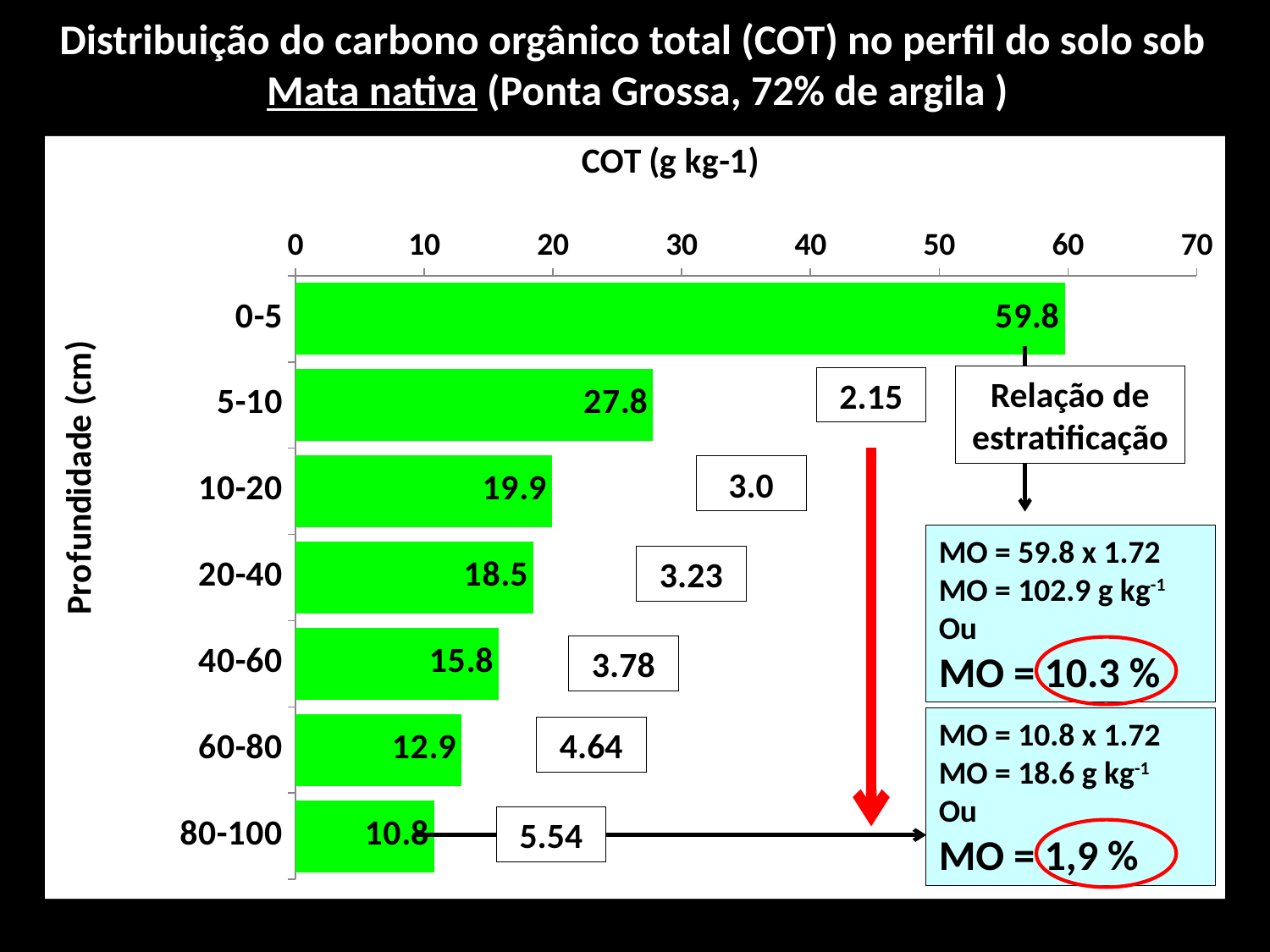
What is the difference between the COT values for 0-5 cm and 5-10 cm? 32.0 What type of chart is shown on the slide? bar chart Is the COT value for 5-10 cm greater or less than 30? less Which has a larger COT value, 40-60 cm or 60-80 cm? 40-60 Do the COT values rise or fall as depth increases from 0-5 cm to 80-100 cm? fall What is the COT value for the 0-5 cm depth? 59.8 What is the difference between the COT values for 10-20 cm and 20-40 cm? 1.4 Which depth interval has the lowest COT value? 80-100 What is the COT value for the 20-40 cm depth? 18.5 How many depth intervals are shown in the chart? 7 What is the COT value for the 80-100 cm depth? 10.8 Which depth interval has the highest COT value? 0-5